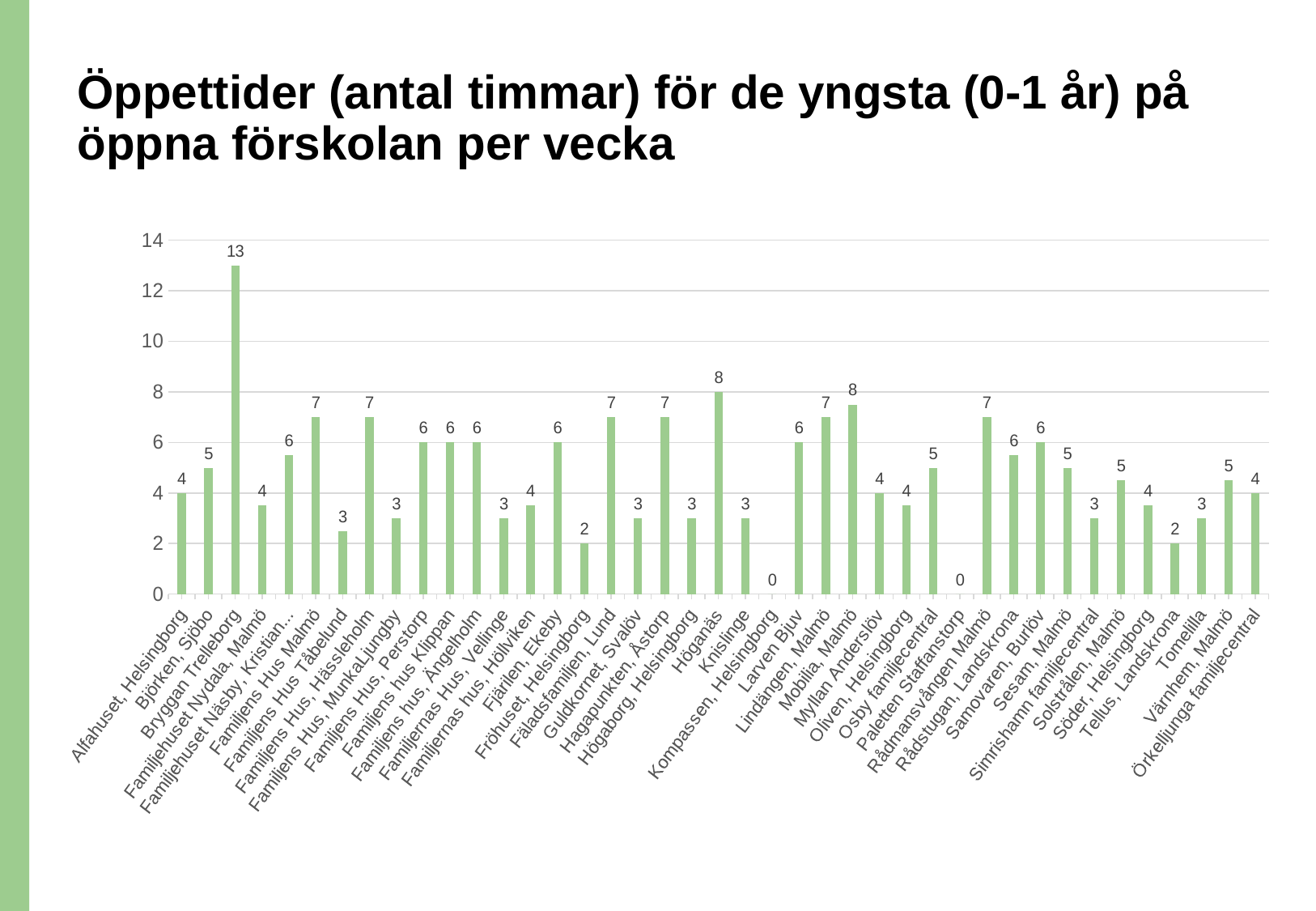
What is the value for Bryggan Trelleborg? 13 What is the value for Fäladsfamiljen, Lund? 7 Which category has the highest value? Bryggan Trelleborg What is the value for Kompassen, Helsingborg? 0 What is the difference between the values for Bryggan Trelleborg and Höganäs? 5 What kind of chart is shown on the slide? bar chart What is the value for Fröhuset, Helsingborg? 2 What is the value for Höganäs? 8 Is the value for Bryggan Trelleborg greater or less than 10? greater Which is larger, the value for Höganäs or the value for Fröhuset, Helsingborg? Höganäs Is the value for Tellus, Landskrona greater or less than 4? less What is the title of the slide? Öppettider (antal timmar) för de yngsta (0-1 år) på öppna förskolan per vecka